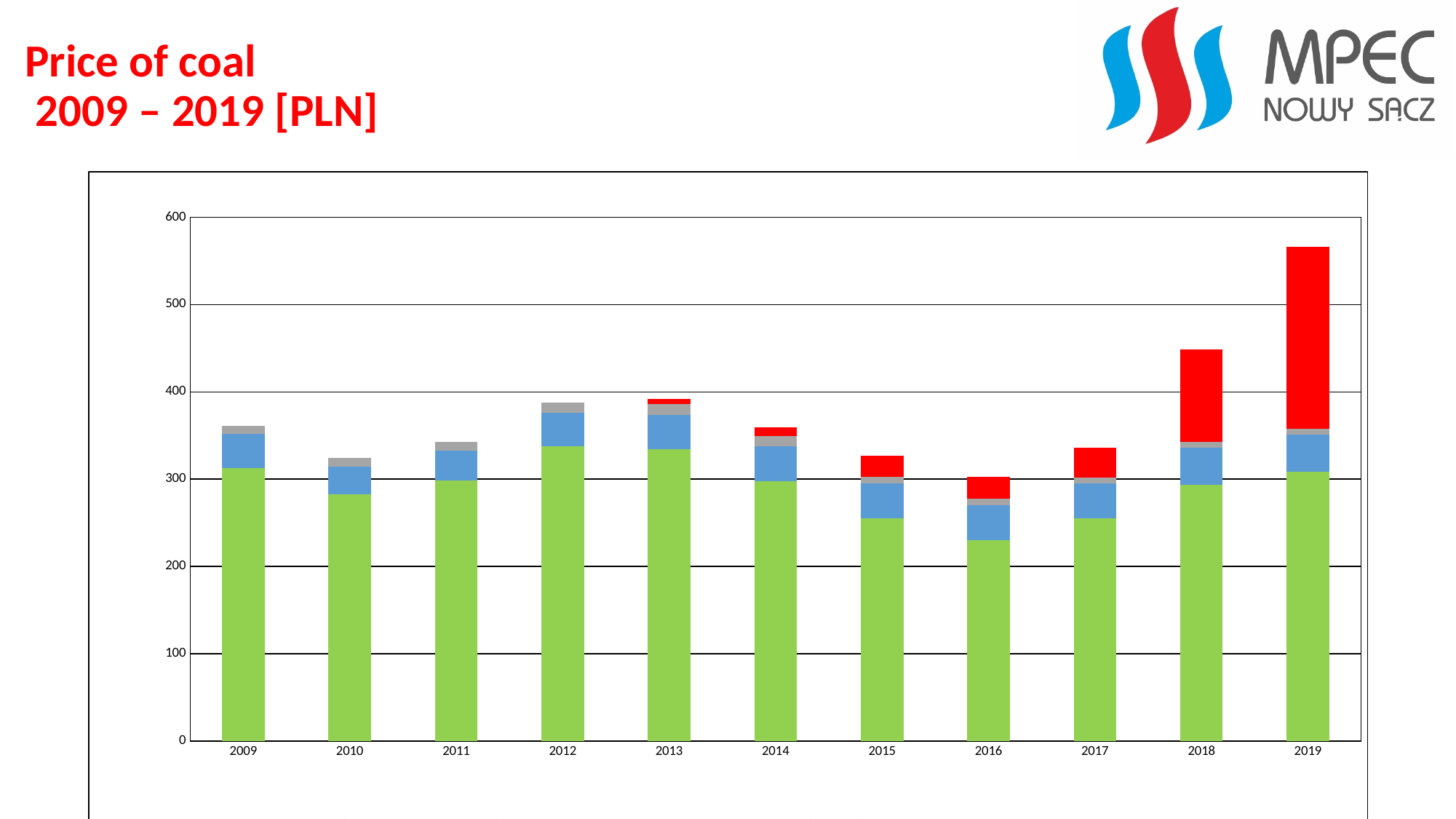
Which year has the lowest total bar in the chart? 2016 Which year has the highest total bar in the chart? 2019 What is the title of the slide containing the chart? Price of coal 2009 – 2019 [PLN] Which year has the larger total bar, 2010 or 2012? 2012 Do the total bar values rise or fall from 2016 to 2019? rise Is the total value for 2009 greater or less than 300? greater Is the total value for 2016 greater or less than 400? less Is the total value for 2019 greater or less than 500? greater Which year has the larger total bar, 2017 or 2018? 2018 What kind of chart is shown on the slide? stacked bar chart How many years are shown on the x axis of the chart? 11